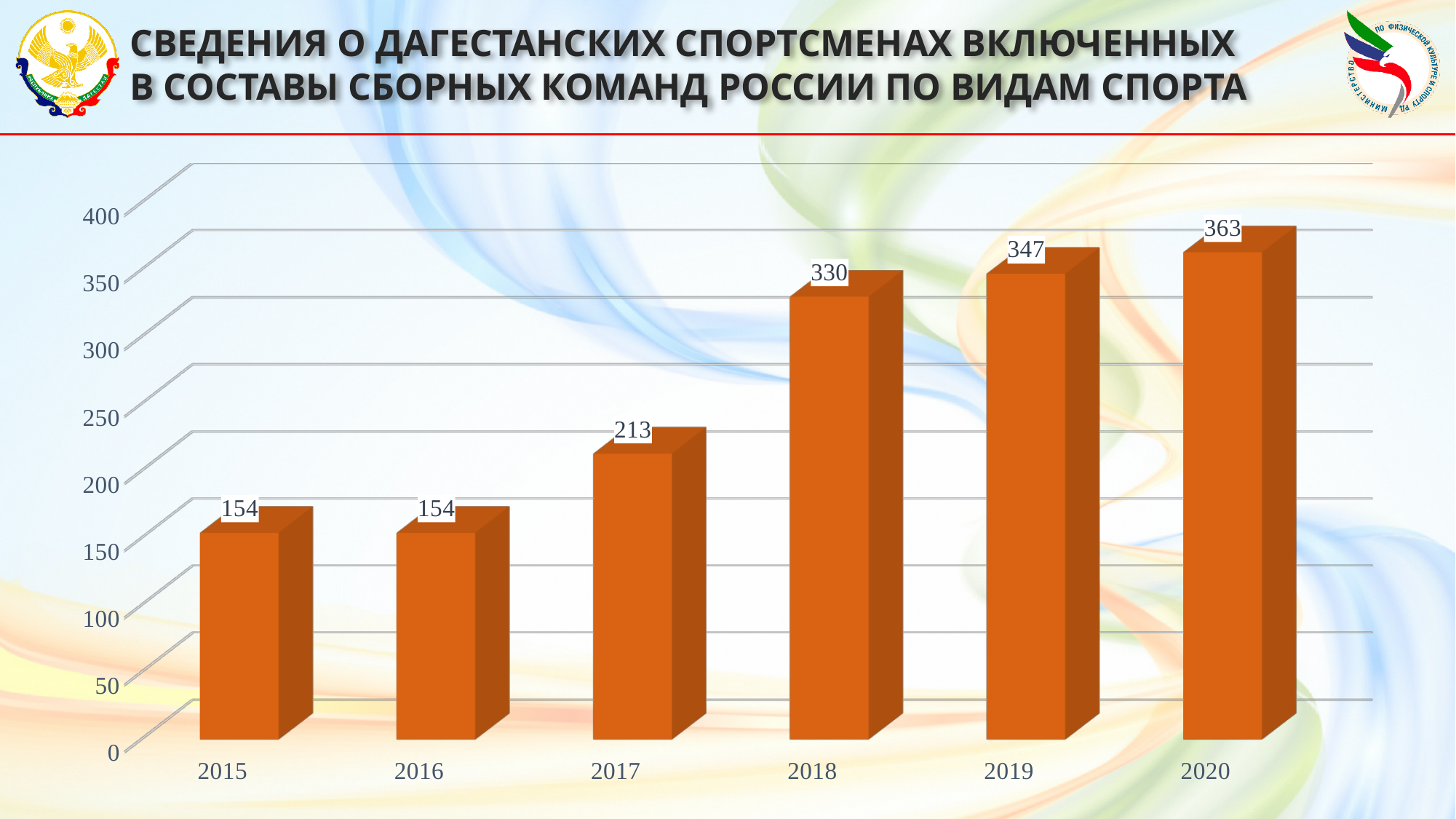
How many years are shown on the x axis? 6 Which year has the highest value? 2020 What kind of chart is shown on the slide? bar chart Is the value for 2019 greater or less than 300? greater What is the difference between the values for 2020 and 2019? 16 What is the value for 2018? 330 What is the difference between the values for 2018 and 2017? 117 Which is larger, the value for 2017 or the value for 2018? 2018 What is the value for 2017? 213 What is the value for 2020? 363 Do the values generally rise or fall from 2015 to 2020? rise Which two years have the same value? 2015 and 2016